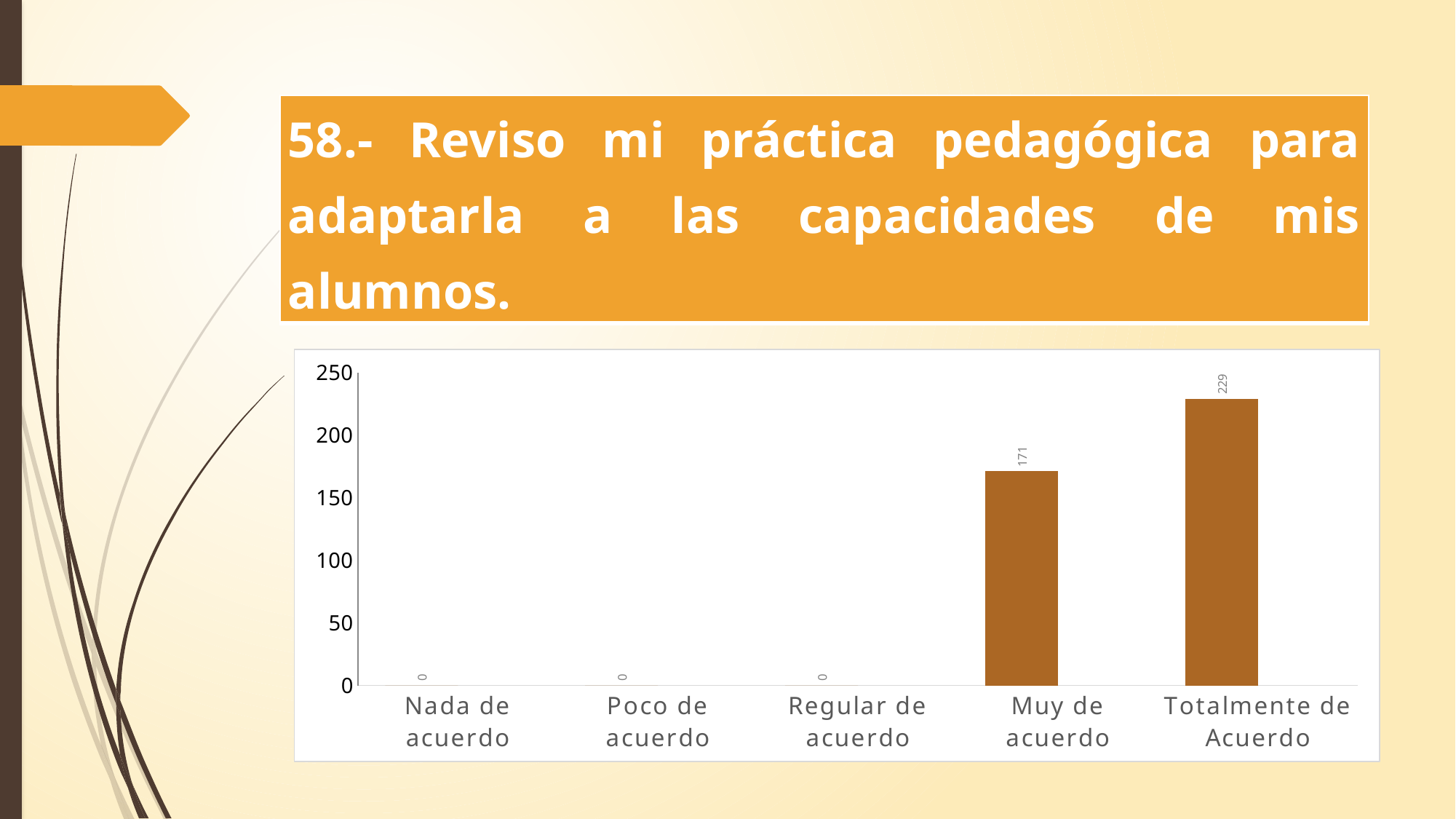
Is the value for "Totalmente de Acuerdo" greater or less than 250? less What is the value for "Muy de acuerdo"? 171 How many categories have a value of 0? 3 What is the difference between the values for "Totalmente de Acuerdo" and "Muy de acuerdo"? 58 What is the value for "Regular de acuerdo"? 0 Which category has the highest value? Totalmente de Acuerdo How many categories are shown on the x axis? 5 Which is larger, the value for "Muy de acuerdo" or the value for "Totalmente de Acuerdo"? Totalmente de Acuerdo Do the values rise or fall from left to right along the x axis? rise What is the value for "Totalmente de Acuerdo"? 229 Is the value for "Muy de acuerdo" greater or less than 150? greater What kind of chart is shown on the slide? bar chart